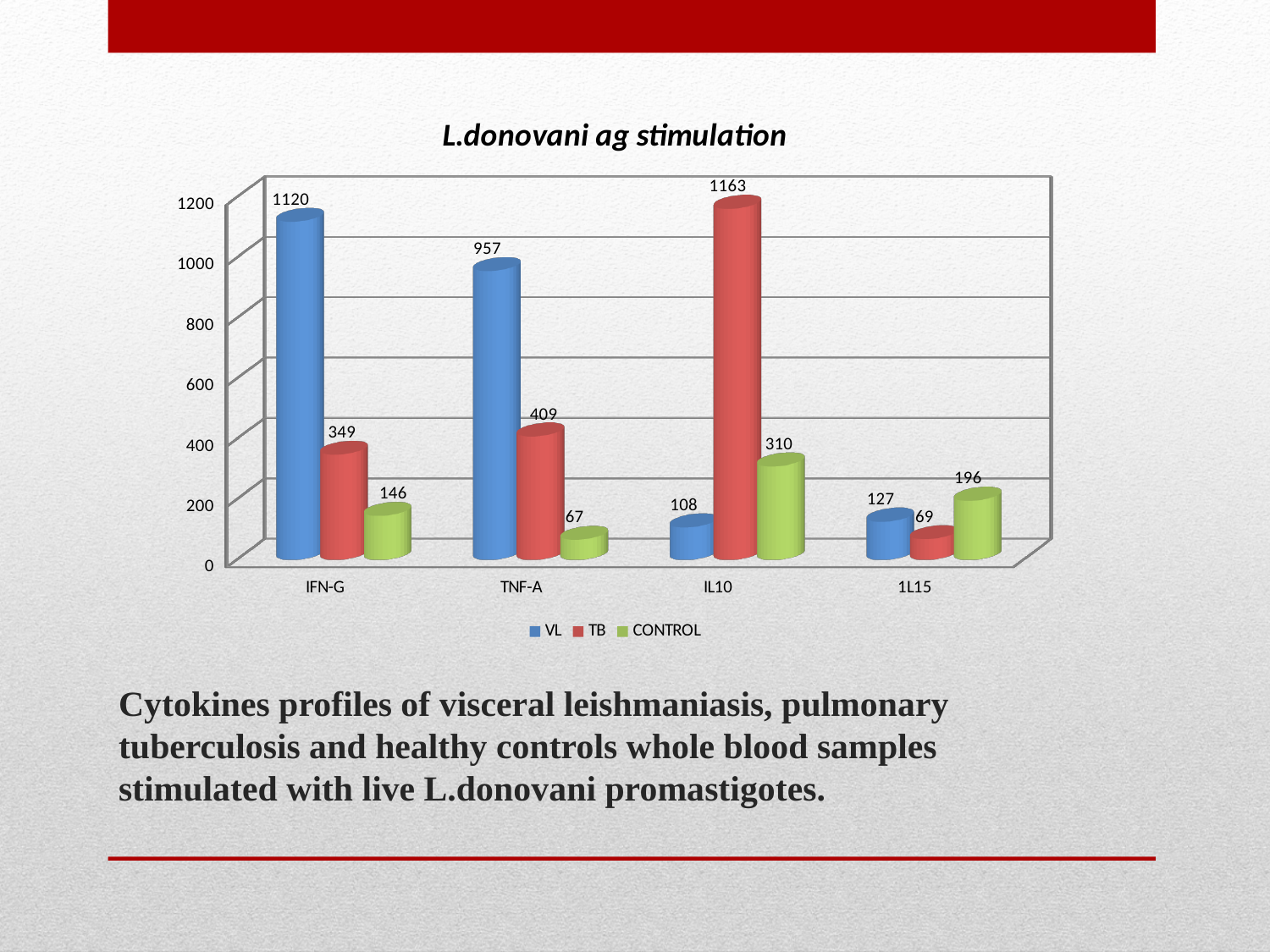
Which category has the lowest TB value? 1L15 Which category has the highest VL value? IFN-G What is the difference between the VL and TB values for TNF-A? 548 What is the CONTROL value for TNF-A? 67 What is the TB value for 1L15? 69 What is the TB value for IL10? 1163 What is the title of the chart? L.donovani ag stimulation How many categories are shown on the x axis? 4 How many series does the legend list? 3 What kind of chart is shown on the slide? Bar chart What is the VL value for IFN-G? 1120 Which is larger for IL10, the TB value or the CONTROL value? TB